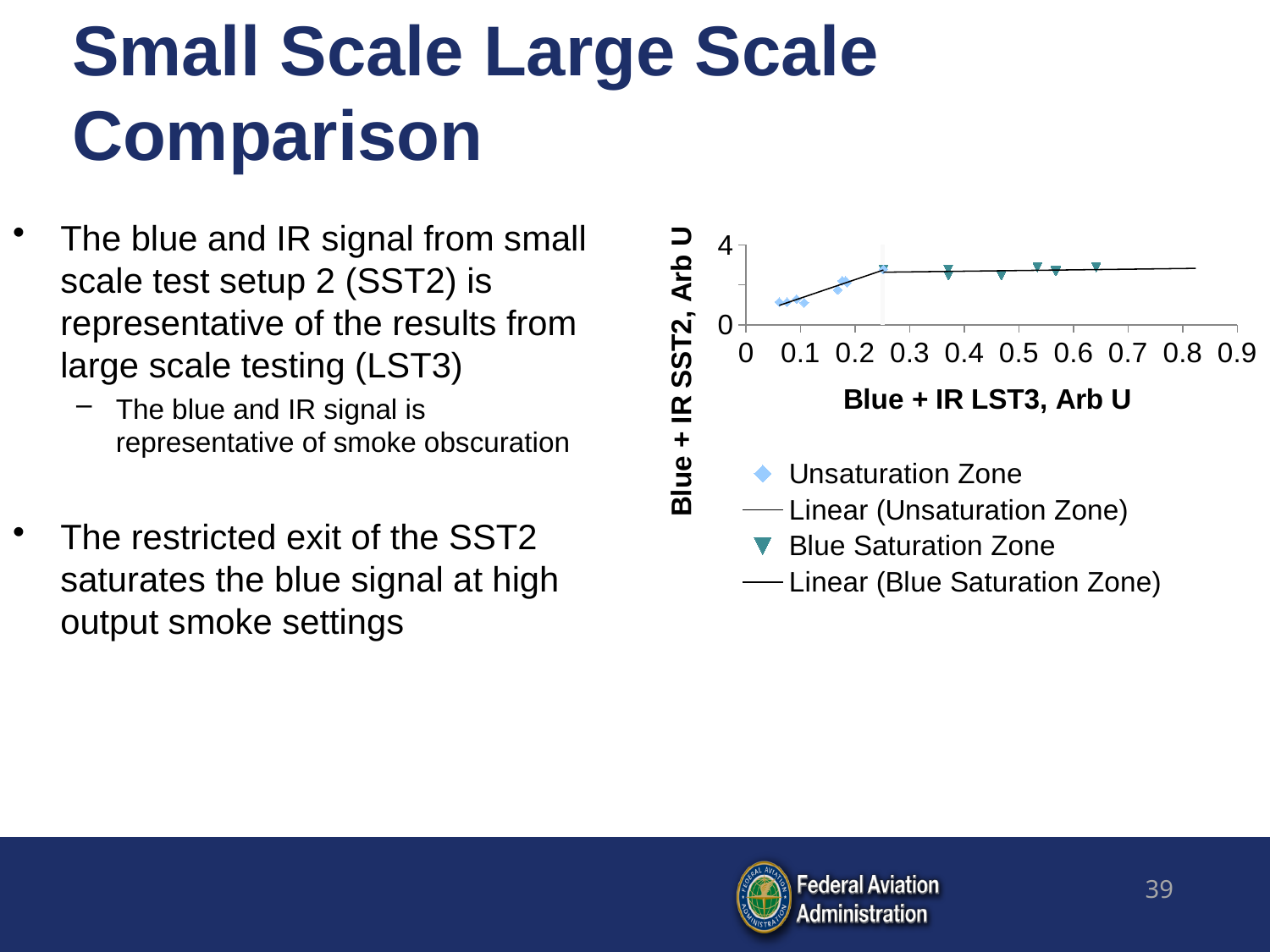
Which series has the higher y-axis values, Unsaturation Zone or Blue Saturation Zone? Blue Saturation Zone What is the title of the y axis of the chart? Blue + IR SST2, Arb U Do the plotted values generally rise or fall as the x-axis value increases? rise What kind of chart is shown on the slide? scatter chart How many entries does the chart's legend list? 4 What is the title of the x axis of the chart? Blue + IR LST3, Arb U Which series has the lowest y-axis values on the chart? Unsaturation Zone What is the highest value labelled on the y axis of the chart? 4 Is the Unsaturation Zone point nearest x = 0.1 greater or less than 2 on the y axis? less Are the Blue Saturation Zone points greater or less than 4 on the y axis? less Are the Blue Saturation Zone points greater or less than 2 on the y axis? greater